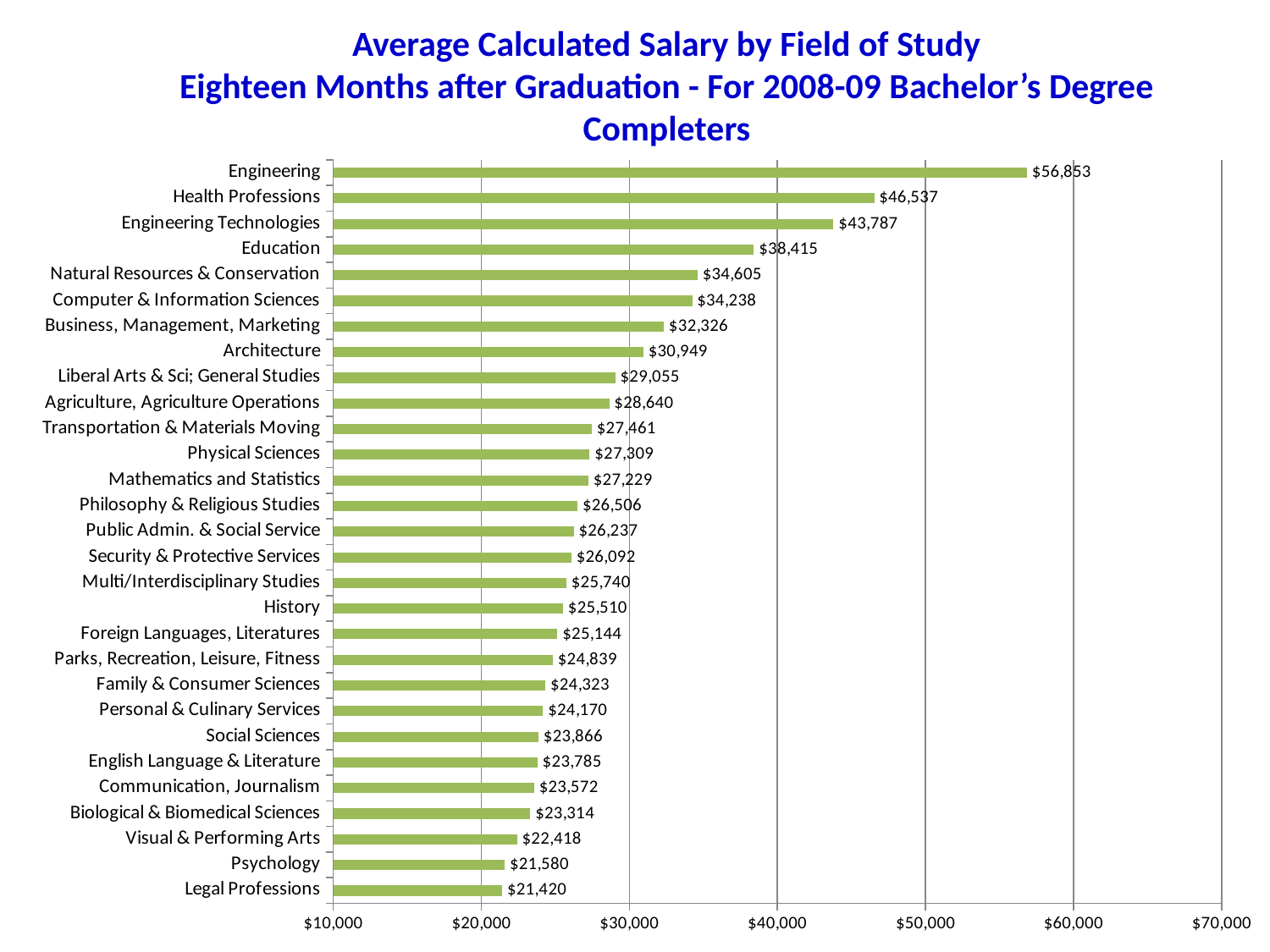
What kind of chart is shown on the slide? Bar chart What is the average calculated salary for Engineering? $56,853 Which field of study has the highest average calculated salary? Engineering What is the average calculated salary for Computer & Information Sciences? $34,238 Which field of study has the lowest average calculated salary? Legal Professions What is the average calculated salary for Psychology? $21,580 What is the title of the chart? Average Calculated Salary by Field of Study Eighteen Months after Graduation - For 2008-09 Bachelor's Degree Completers How many fields of study are shown in the chart? 29 Which has a higher average calculated salary, Engineering Technologies or Education? Engineering Technologies Is the average salary for Natural Resources & Conservation greater or less than $30,000? greater What is the difference between the average salary for Education and for Architecture? $7,466 What is the difference between the average salary for Engineering and for Health Professions? $10,316